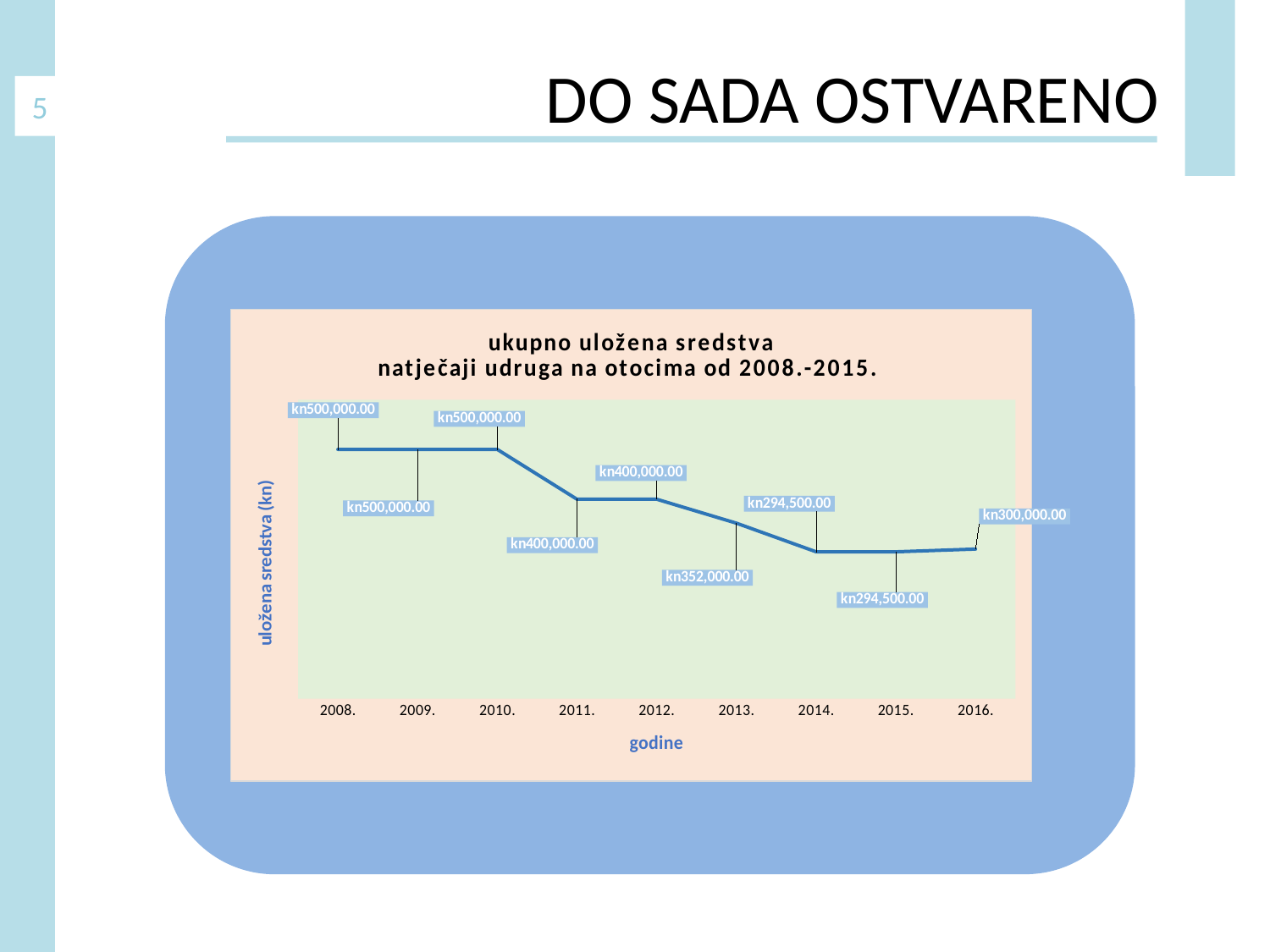
What is the label of the x axis? godine Which is larger, the value for 2012. or the value for 2016.? 2012. What is the difference between the values for 2010. and 2011.? kn100,000.00 Which year has the lowest value? 2014. and 2015. What is the value for 2013.? kn352,000.00 What is the value for 2011.? kn400,000.00 How many years are plotted on the x axis? 9 What kind of chart is shown on the slide? line chart What is the difference between the values for 2013. and 2014.? kn57,500.00 What is the value for 2008.? kn500,000.00 What is the value for 2014.? kn294,500.00 What is the value for 2016.? kn300,000.00